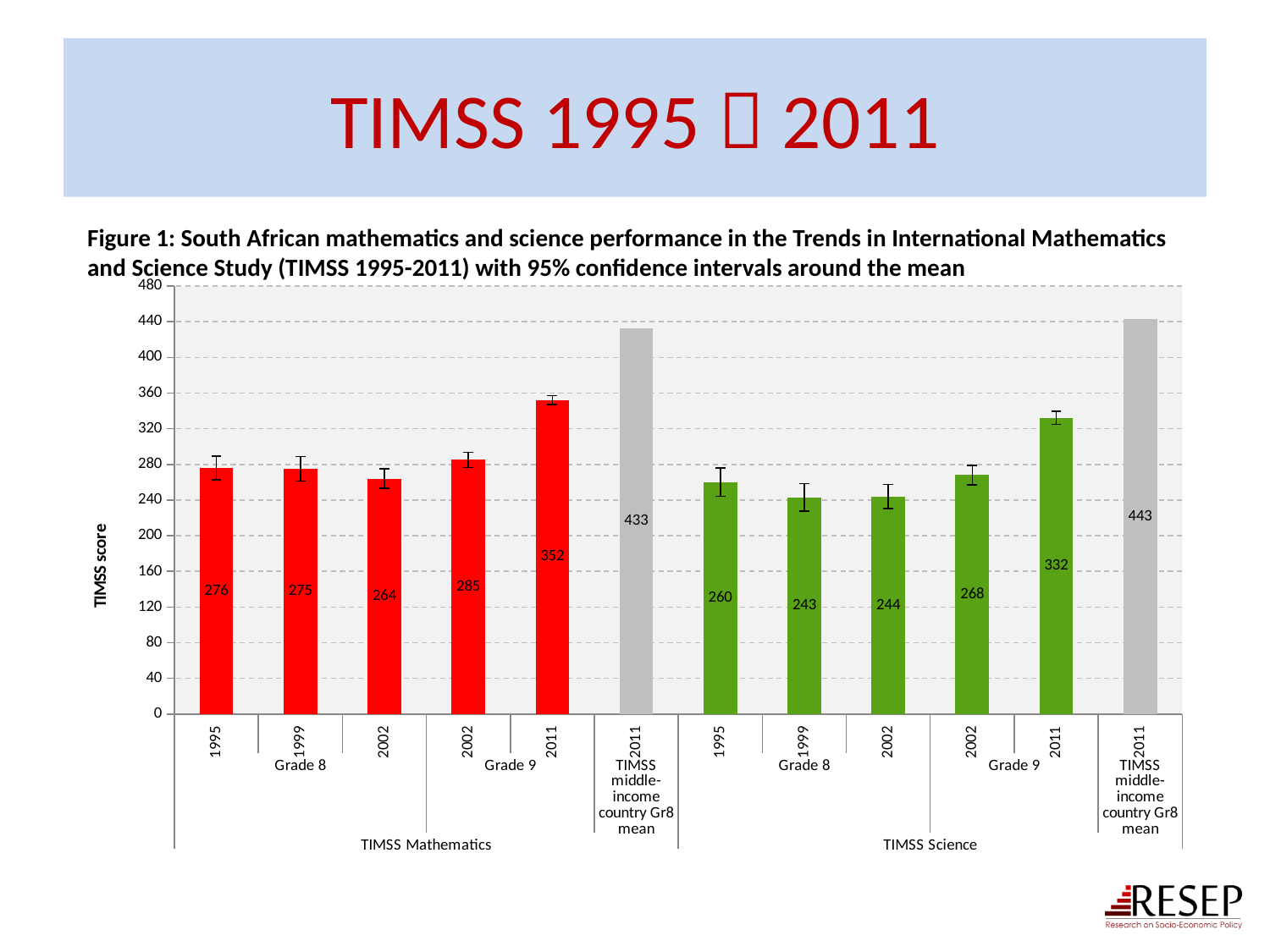
What is the difference between the Grade 9 2011 Mathematics score and the Grade 9 2002 Mathematics score? 67 Which South African TIMSS Science bar has the lowest score? Grade 8, 1999 (243) Which is larger, the Grade 8 1995 Mathematics score or the Grade 8 1995 Science score? Grade 8 1995 Mathematics score (276) How many bars are plotted on the chart? 12 What is the TIMSS Mathematics score for Grade 9 in 2011? 352 What is the TIMSS middle-income country Gr8 mean for Science in 2011? 443 What is the difference between the TIMSS middle-income country Gr8 mean for Science and the Grade 9 2011 Science score? 111 What is the TIMSS Science score for Grade 8 in 1999? 243 What kind of chart is shown on the slide? Bar chart What is the TIMSS Mathematics score for Grade 8 in 2002? 264 What is the label of the vertical axis? TIMSS score Which bar has the highest value on the chart? TIMSS Science, TIMSS middle-income country Gr8 mean 2011 (443)